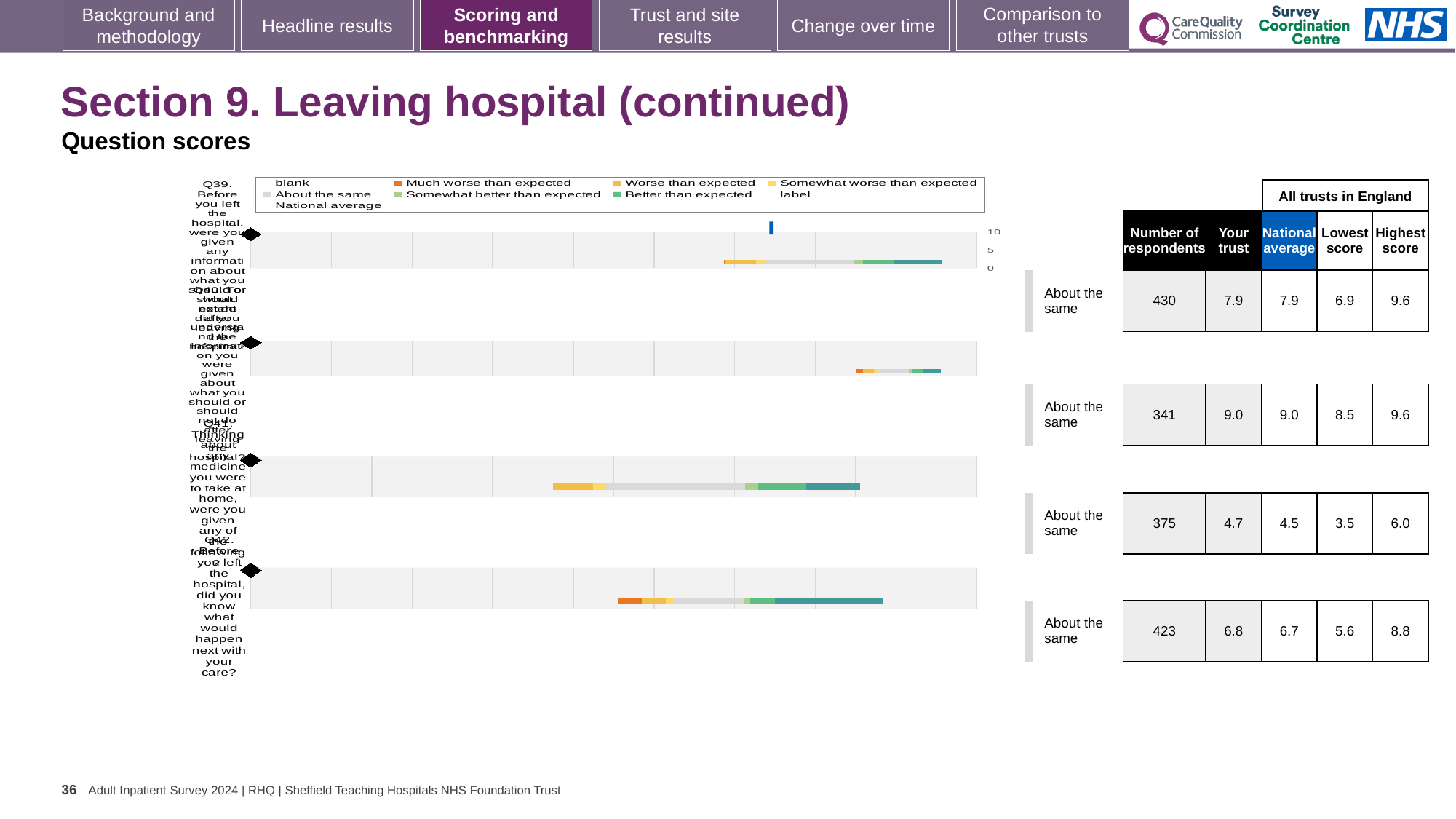
For the Q39 chart, what is the 'Your trust' score shown in the table to its right? 7.9 For the Q41 chart, what is the 'Your trust' score shown in the table to its right? 4.7 For the Q39 chart, what benchmark category is shown in the label to its right? About the same In the legend above the charts, which colour represents 'Much worse than expected'? orange In the legend above the charts, which colour represents 'Better than expected'? teal Which of the four question charts has the lowest 'Your trust' score in the table? Q41 How many question benchmark charts are shown on the slide? 4 For the Q42 chart, what is the 'Your trust' score shown in the table to its right? 6.8 Which of the four question charts has the highest 'Your trust' score in the table? Q40 What kind of chart is used for the Q39 benchmark chart on the slide? bar chart For the Q40 chart, what is the 'Your trust' score shown in the table to its right? 9.0 For the Q42 chart, what is the difference between the 'Your trust' score and the 'National average' in the table? 0.1